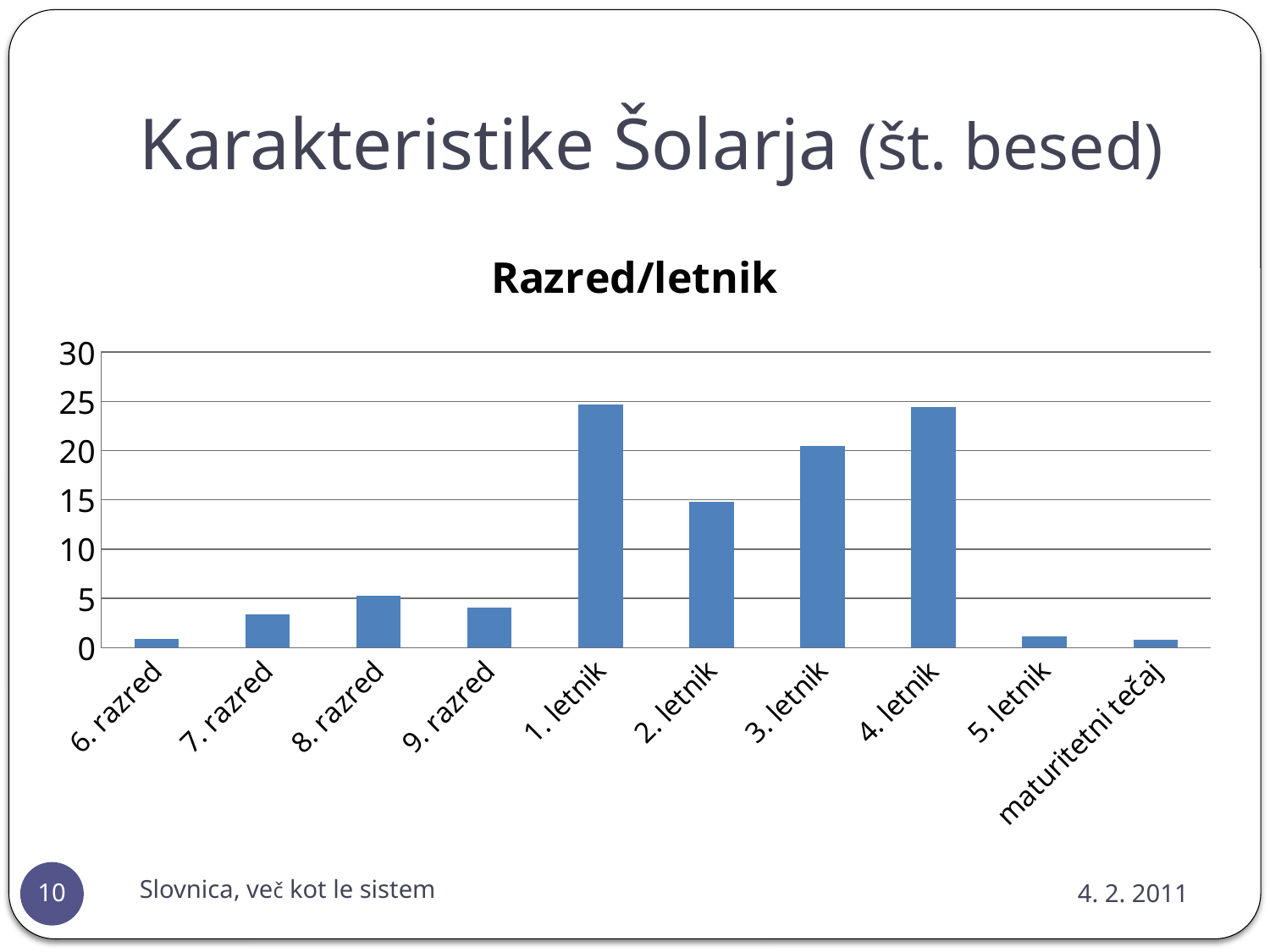
Is the value for 2. letnik greater or less than 10? greater What type of chart is shown on the slide? bar chart Is the value for 5. letnik greater or less than 5? less What is the title of the chart? Razred/letnik Which has a larger value, 8. razred or 6. razred? 8. razred How many categories are shown on the x axis of the chart? 10 Which has a larger value, 3. letnik or 2. letnik? 3. letnik Is the value for 1. letnik greater or less than 20? greater Which has a larger value, 1. letnik or 2. letnik? 1. letnik